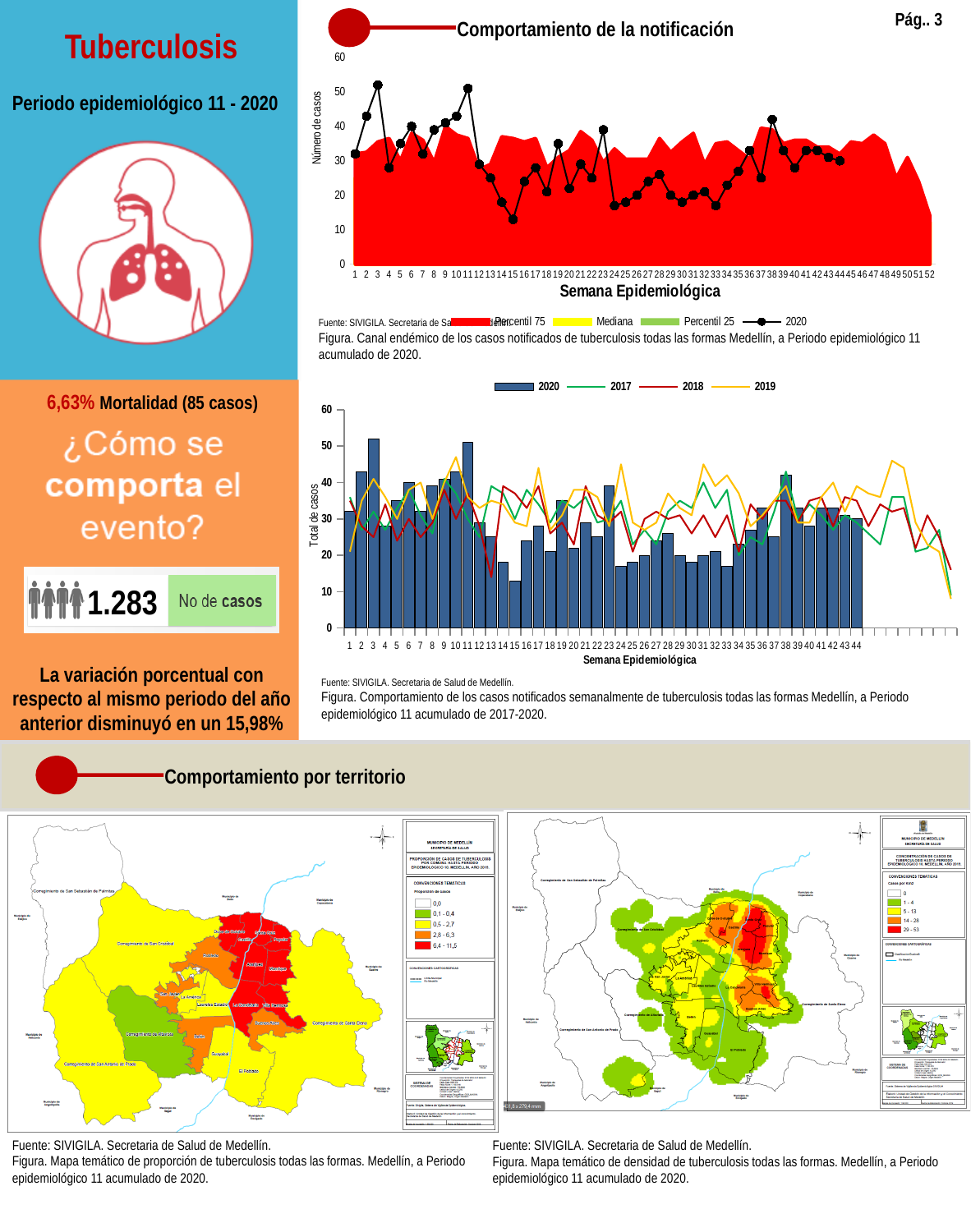
In the second chart (2017-2020 weekly cases), is the 2020 bar for week 23 greater or less than 30? greater In the second chart (2017-2020 weekly cases), how many weeks are labelled on the x axis? 44 In the second chart (2017-2020 weekly cases), which year is shown as bars rather than a line? 2020 In the second chart (2017-2020 weekly cases), is the 2020 bar for week 15 greater or less than 20? less In the 'Comportamiento de la notificación' chart, what is the title of the x axis? Semana Epidemiológica In the 'Comportamiento de la notificación' chart, which week has the lowest 2020 value? 15 In the second chart (2017-2020 weekly cases), how many series does the legend list? 4 In the second chart (2017-2020 weekly cases), which week has the lowest 2020 bar? 15 In the 'Comportamiento de la notificación' chart, is the 2020 value for week 15 greater or less than 20? less In the 'Comportamiento de la notificación' chart, how many series does the legend list? 4 In the 'Comportamiento de la notificación' chart, how many epidemiological weeks are labelled on the x axis? 52